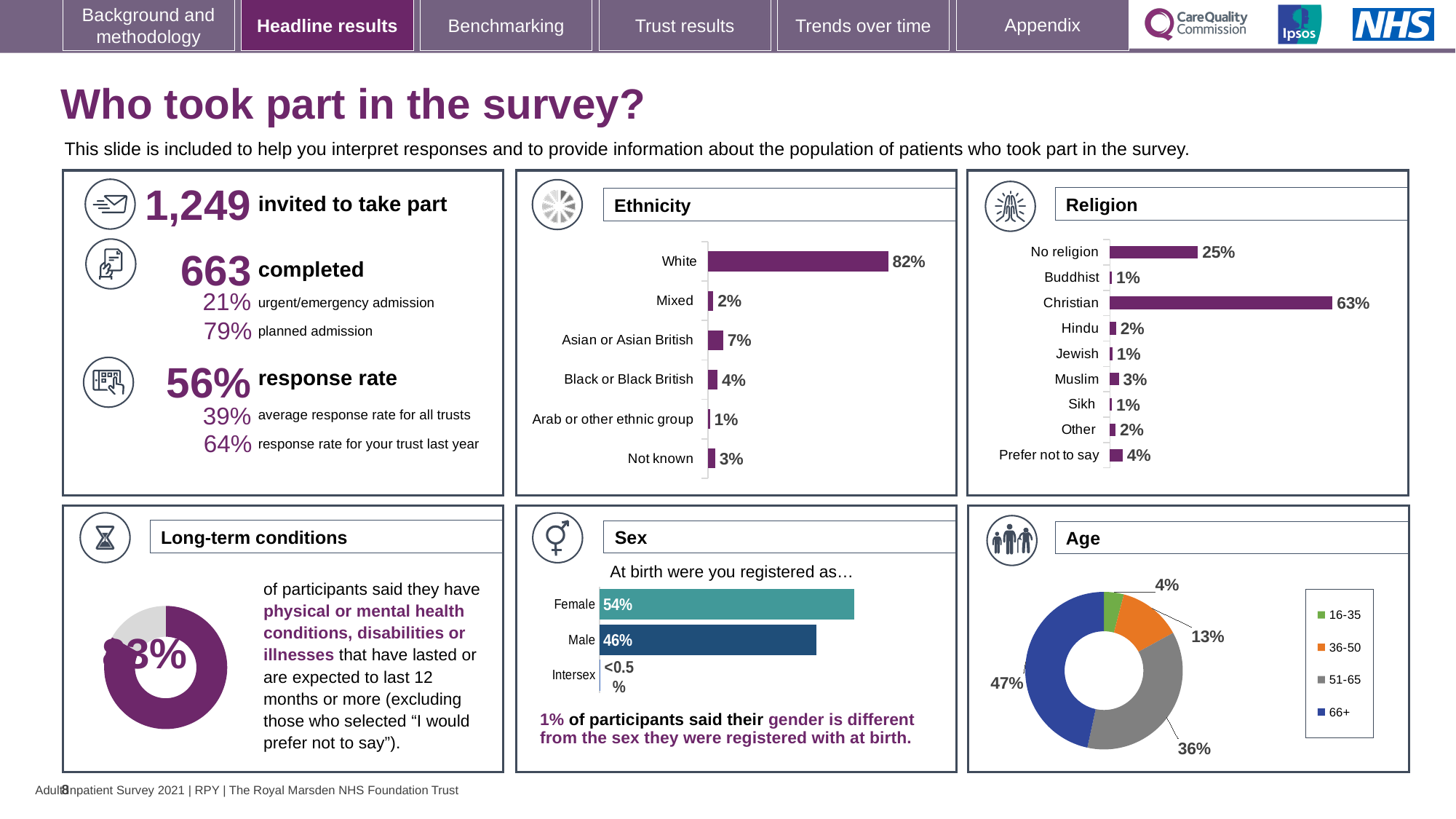
How many categories are shown in the Religion chart? 9 In the Ethnicity chart, what is the difference between the Asian or Asian British and Black or Black British percentages? 3% In the Age chart, what share of participants were aged 66+? 47% In the Sex chart, what percentage of participants were registered as Female at birth? 54% How many categories are shown in the Ethnicity chart? 6 How many age groups does the legend of the Age chart list? 4 In the Religion chart, what percentage of participants were Christian? 63% In the Religion chart, which category has the highest percentage? Christian In the Religion chart, which is larger: No religion or Muslim? No religion In the Ethnicity chart, what percentage of participants were White? 82% In the Sex chart, what is the difference between the Female and Male percentages? 8% In the Ethnicity chart, which ethnic group has the lowest percentage? Arab or other ethnic group